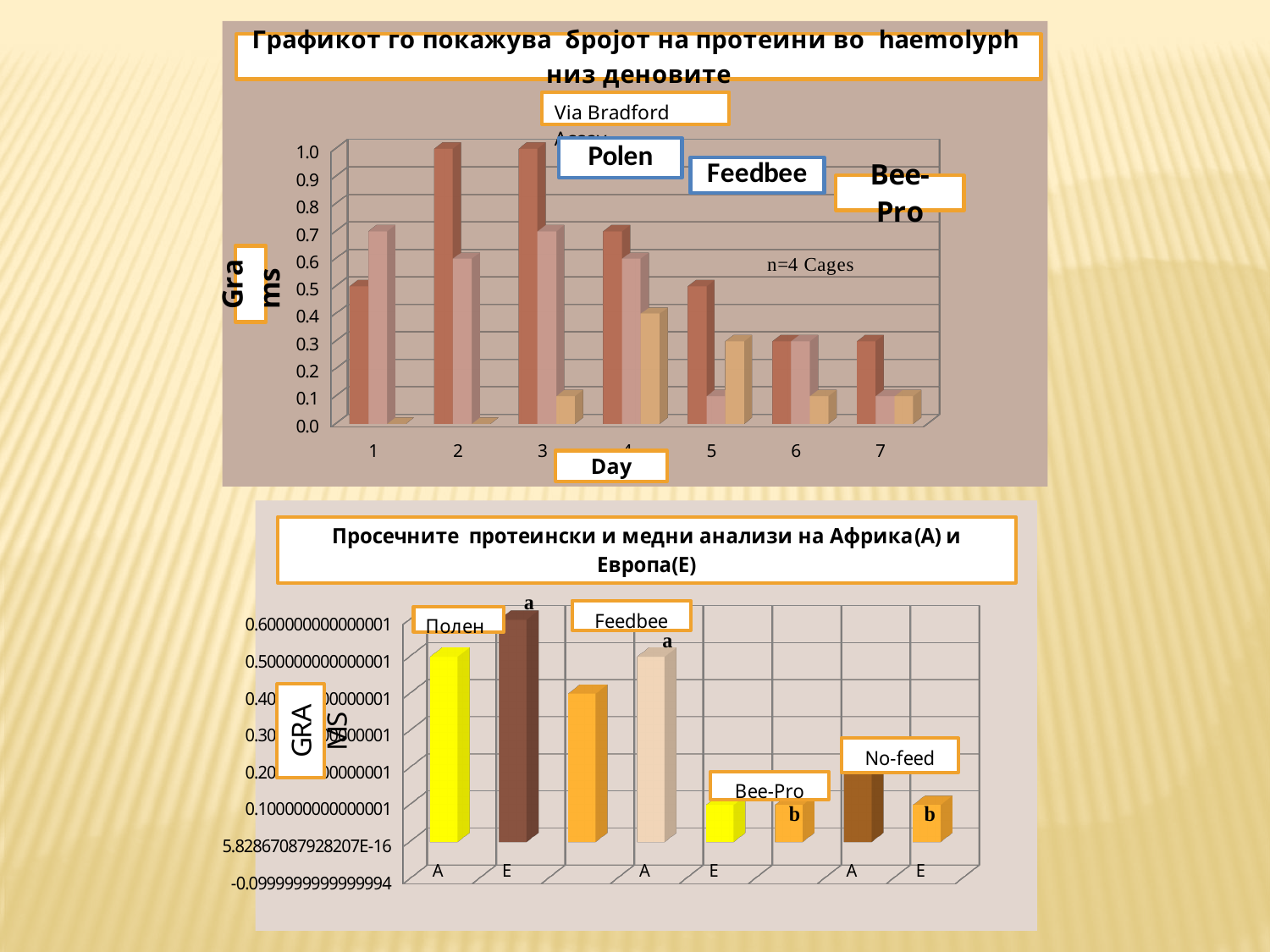
On the top chart (protein in haemolymph across days), is the Bee-Pro value on Day 1 greater or less than 0.1? less On the top chart (protein in haemolymph across days), do the Polen values rise or fall from Day 3 to Day 7? fall On the bottom chart (Africa vs Europe analyses), is the Полен value for E greater or less than 0.5? greater On the bottom chart (Africa vs Europe analyses), how many feed groups are labelled? 4 On the top chart (protein in haemolymph across days), how many feed series are labelled? 3 On the top chart (protein in haemolymph across days), on which day is the Bee-Pro value highest? Day 4 On the bottom chart (Africa vs Europe analyses), which is larger for Полен, A or E? E On the top chart (protein in haemolymph across days), which is larger on Day 1, Polen or Feedbee? Feedbee On the top chart (protein in haemolymph across days), what kind of chart is shown? bar chart On the top chart (protein in haemolymph across days), what annotation about the number of cages is shown? n=4 Cages On the top chart (protein in haemolymph across days), is the Polen value on Day 2 greater or less than 0.9? greater On the top chart (protein in haemolymph across days), how many days are shown on the x axis? 7